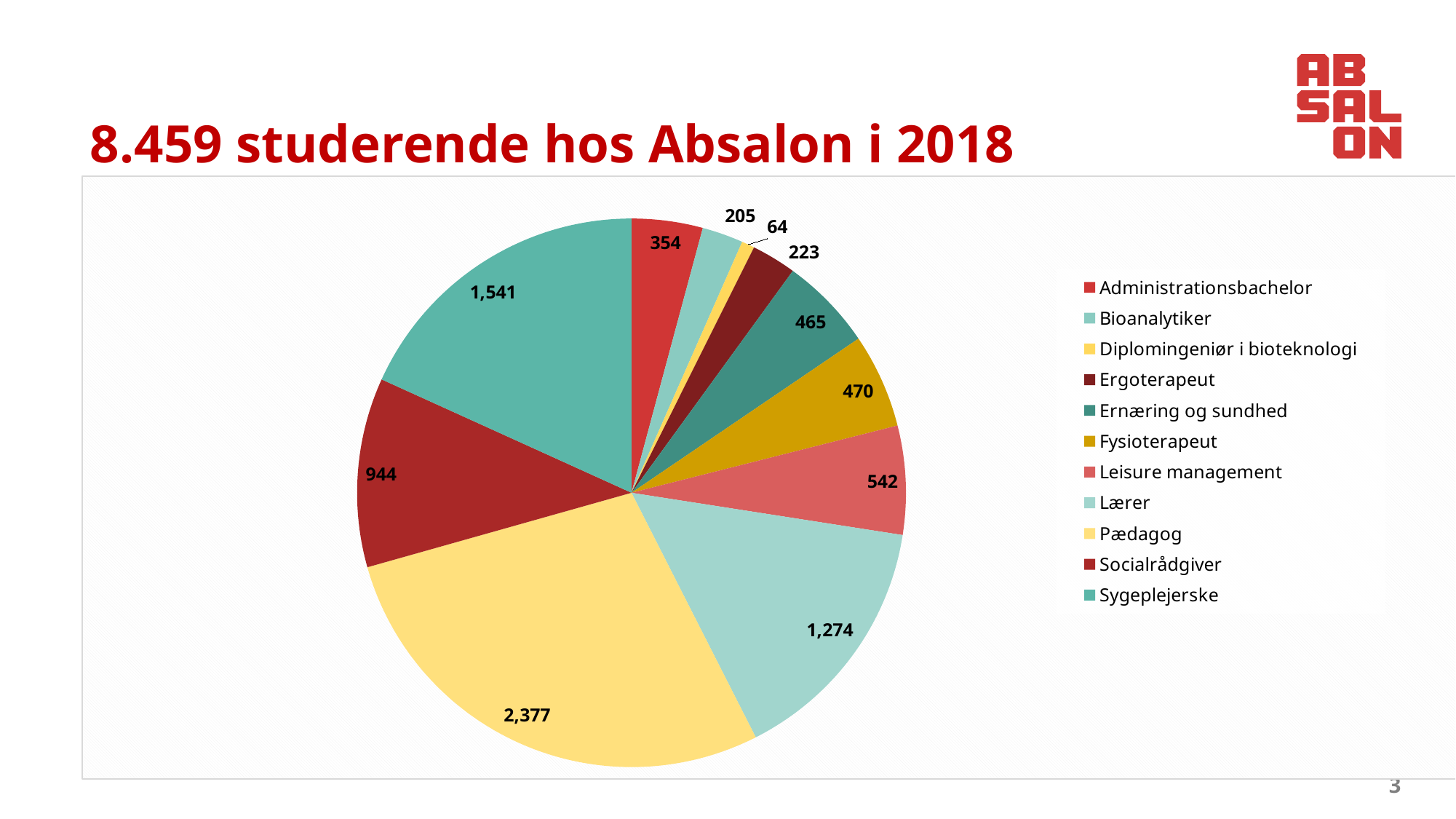
What kind of chart is shown on the slide? Pie chart How many students are in the Pædagog category? 2,377 Which category has the smallest slice of the pie? Diplomingeniør i bioteknologi How many categories does the pie chart show? 11 Which is larger, the value for Fysioterapeut or the value for Ernæring og sundhed? Fysioterapeut Which category has the largest slice of the pie? Pædagog Which is larger, the value for Administrationsbachelor or the value for Ergoterapeut? Administrationsbachelor What is the value shown for Ernæring og sundhed? 465 What is the title of the slide containing the chart? 8.459 studerende hos Absalon i 2018 What is the value shown for Socialrådgiver? 944 What is the difference between the values for Leisure management and Fysioterapeut? 72 What is the difference between the values for Sygeplejerske and Lærer? 267